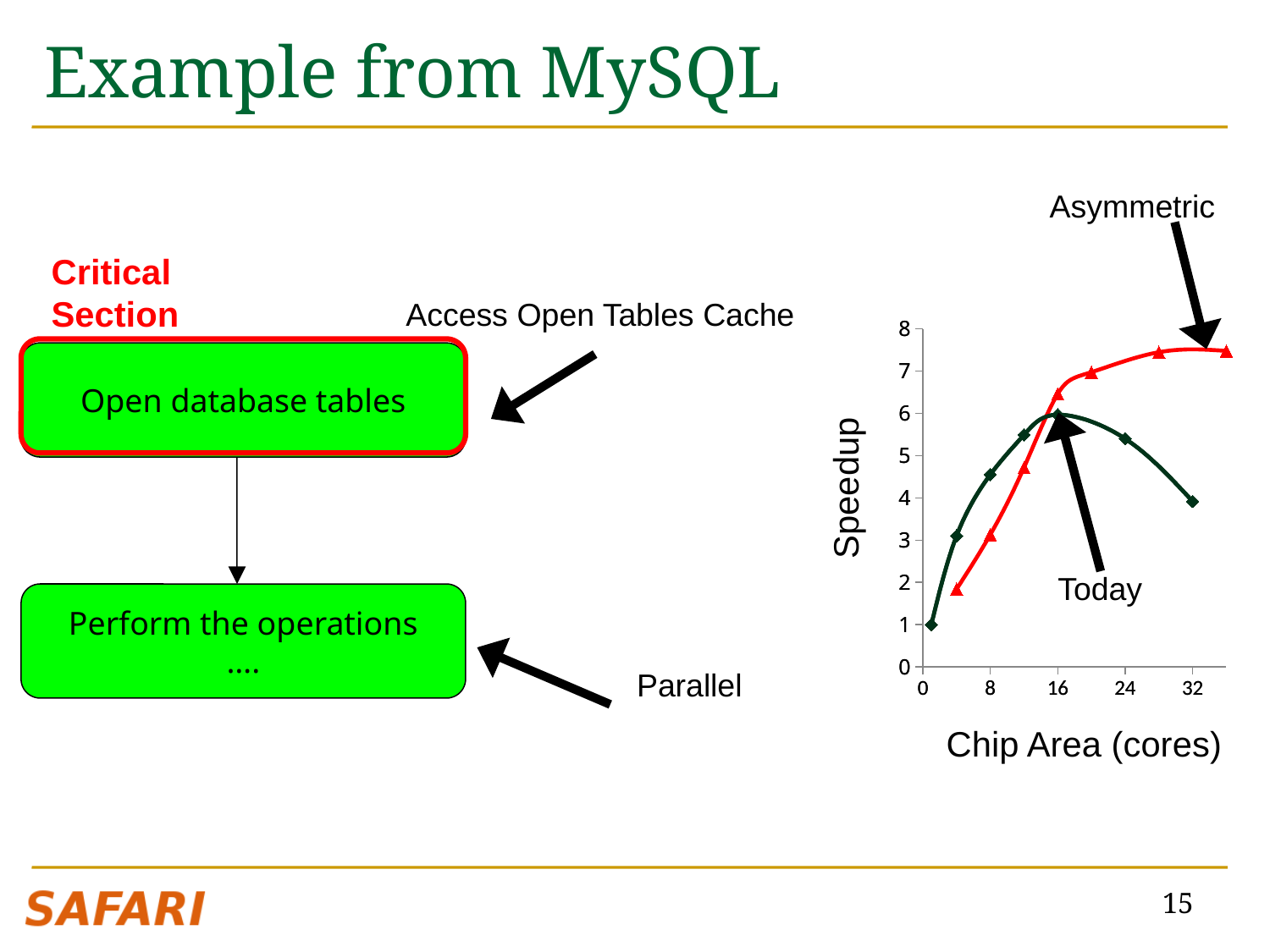
What is the label of the x axis of the Speedup chart? Chip Area (cores) In the Speedup chart, is the Asymmetric value at 32 cores greater or less than 7? greater In the Speedup chart, is the Today value at 32 cores greater or less than 5? less What kind of chart is shown on the right of the slide? line chart How many lines (series) are plotted in the Speedup chart? 2 In the Speedup chart, which line has the higher speedup at 8 cores, Asymmetric or Today? Today What is the label of the y axis of the chart on the right? Speedup In the Speedup chart, at what chip area (cores) does the Today line reach its peak? 16 In the Speedup chart, does the Asymmetric line rise or fall as chip area increases? rises In the Speedup chart, which line has the higher speedup at 32 cores, Asymmetric or Today? Asymmetric In the Speedup chart, is the Today value at 8 cores greater or less than 4? greater